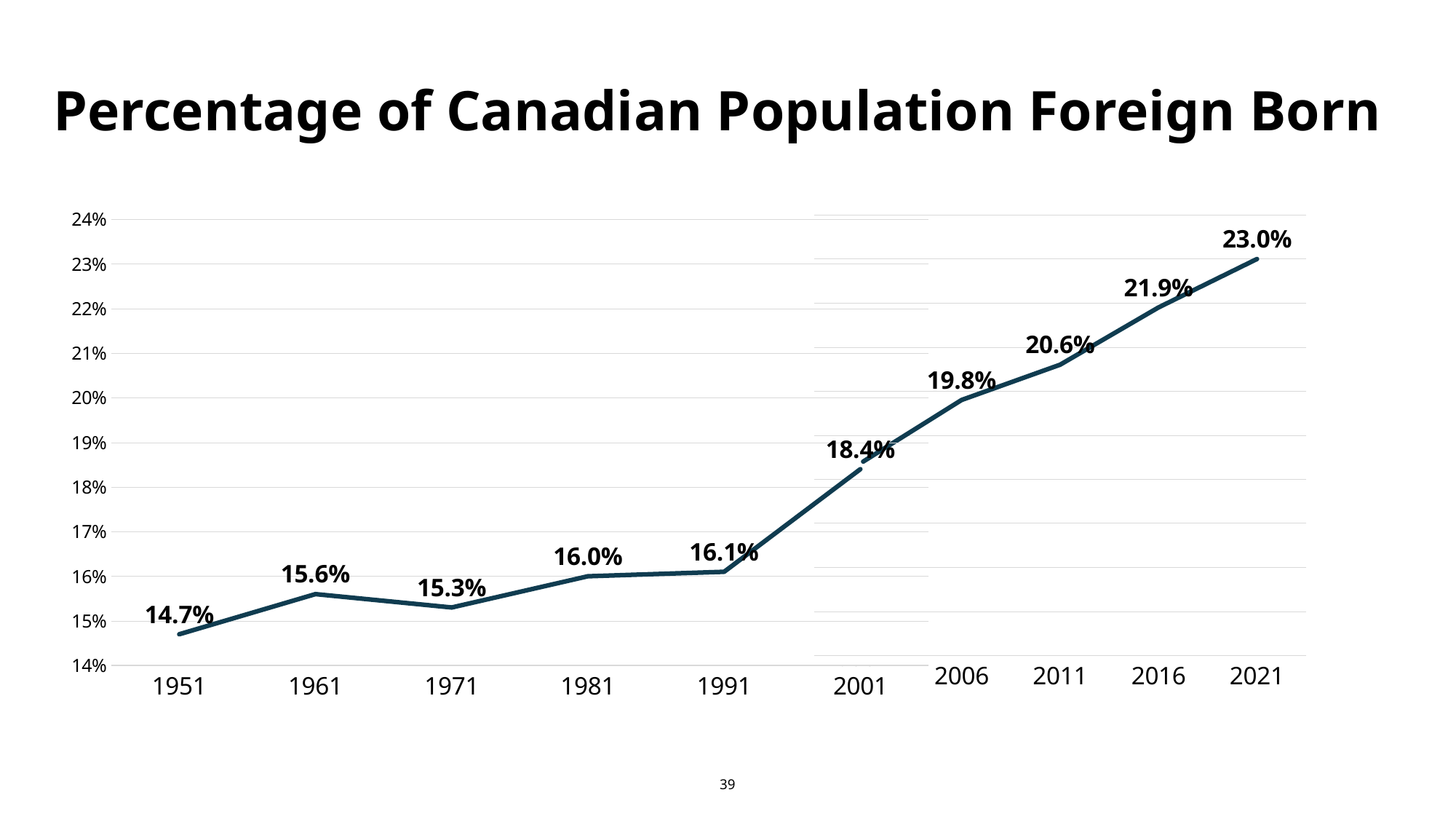
Which year has the lowest percentage of foreign-born population? 1951 How many years are plotted on the chart? 10 What is the value shown for 2001? 18.4% Which year has a higher value, 1961 or 1971? 1961 What kind of chart is shown on the slide? Line chart What is the difference between the values for 2016 and 2011? 1.3% What is the title of the chart? Percentage of Canadian Population Foreign Born Do the values generally rise or fall from 1951 to 2021? Rise What percentage of the Canadian population was foreign born in 1951? 14.7% What is the difference between the values for 2021 and 1951? 8.3% What is the value shown for 2021? 23.0% Which year has the highest percentage of foreign-born population? 2021